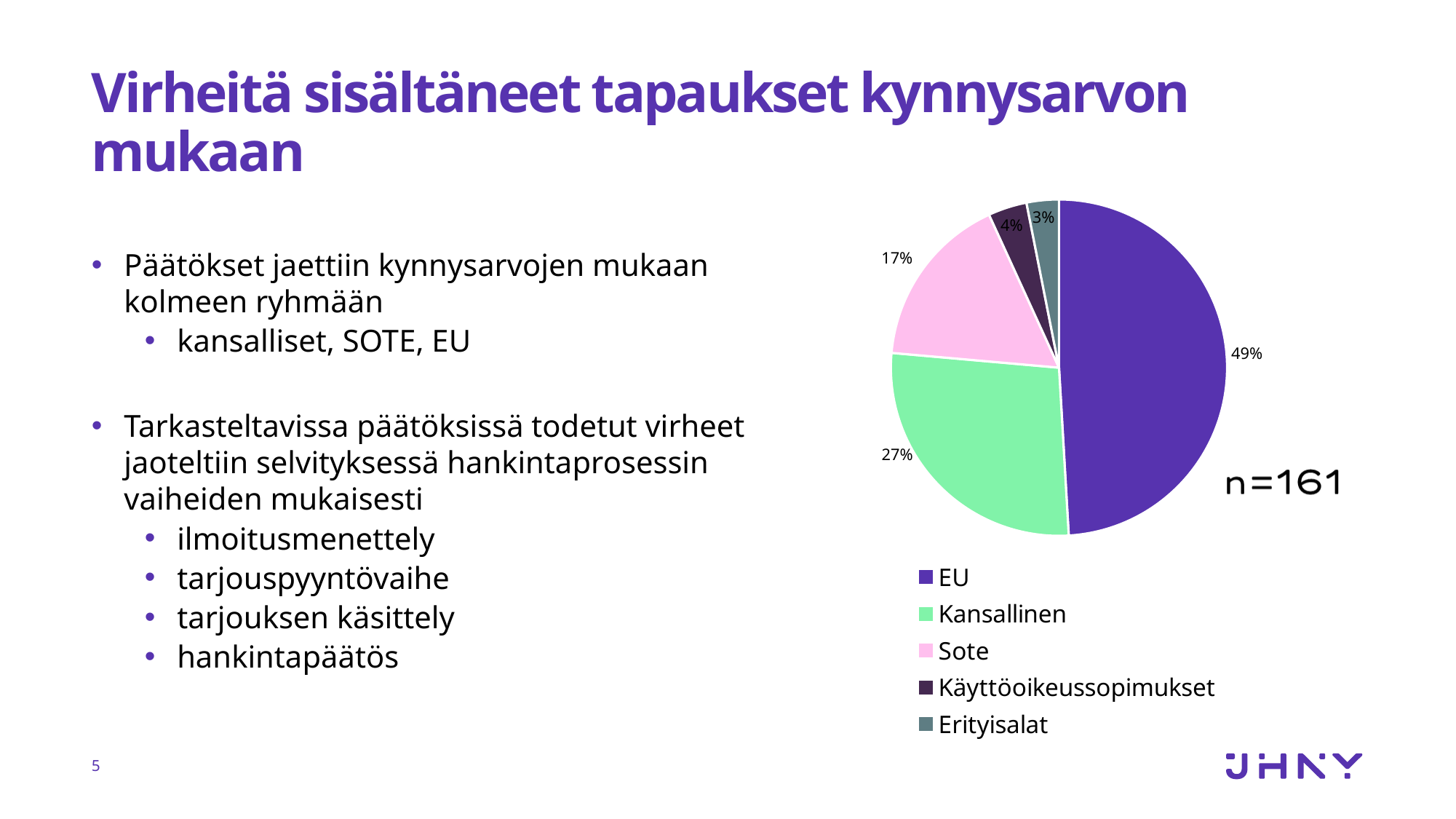
Which slice is larger, Sote or Kansallinen? Kansallinen How many categories does the legend of the pie chart list? 5 What is the difference in percentage points between the EU slice and the Kansallinen slice? 22 What share of the pie does Sote account for? 17% What type of chart is shown on the slide? pie chart What share of the pie does Kansallinen account for? 27% What share of the pie does EU account for? 49% Which category has the largest slice of the pie? EU What share of the pie does Käyttöoikeussopimukset account for? 4% What share of the pie does Erityisalat account for? 3% What sample size (n) is shown next to the pie chart? n=161 Which category has the smallest slice of the pie? Erityisalat